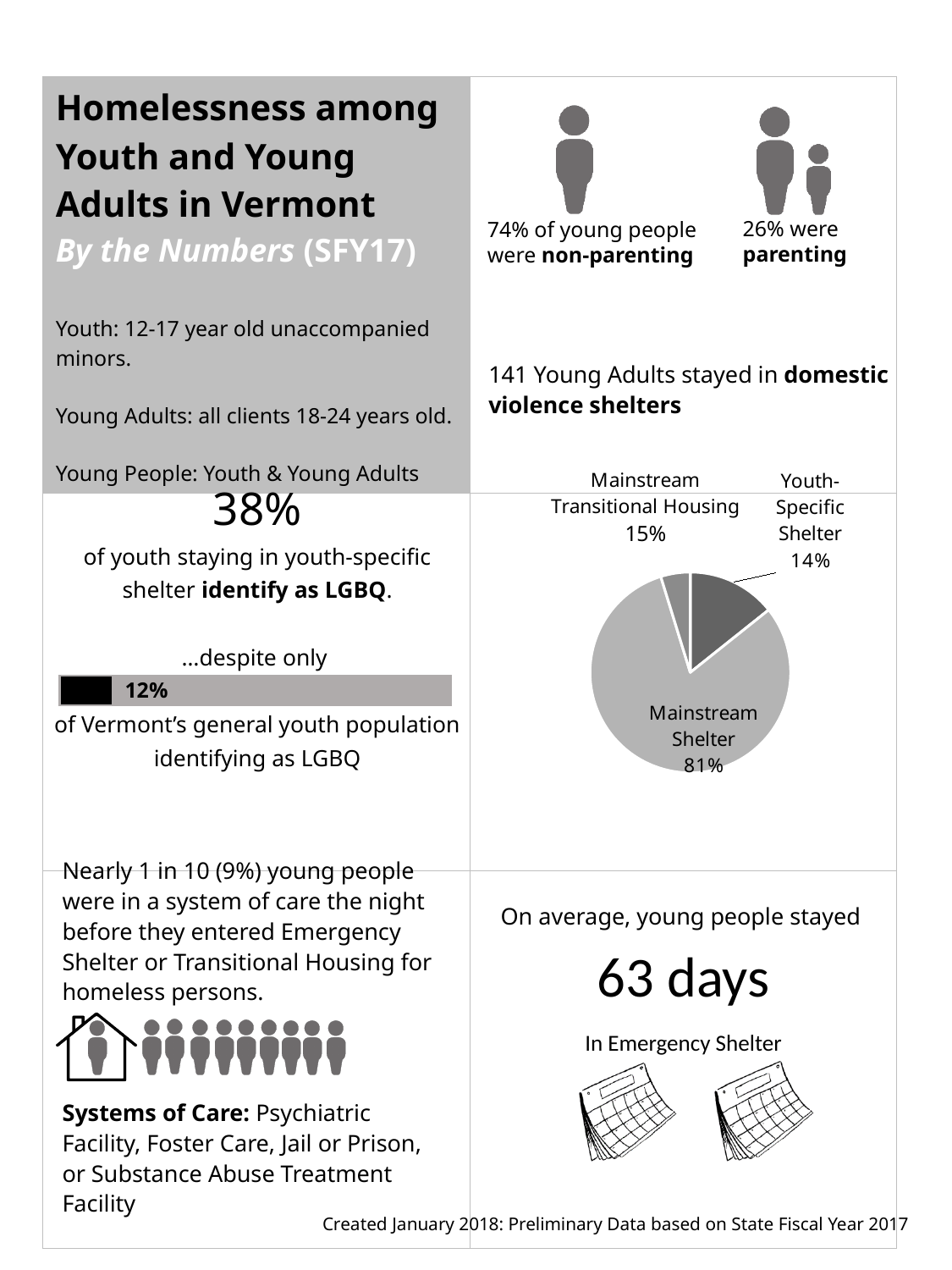
What is the value shown for Youth-Specific Shelter in the pie chart? 14% What percentage is shown on the horizontal bar in the LGBQ section of the slide? 12% Which is larger in the pie chart, Mainstream Shelter or Mainstream Transitional Housing? Mainstream Shelter What kind of chart is shown on the slide? pie chart Which slice of the pie chart is the largest? Mainstream Shelter What share of the pie chart is Mainstream Shelter? 81% What is the difference between the Mainstream Shelter and Youth-Specific Shelter values in the pie chart? 67% How many slices does the pie chart have? 3 What is the difference between the Mainstream Shelter and Mainstream Transitional Housing values in the pie chart? 66% Which slice of the pie chart is shown in the darkest shade? Youth-Specific Shelter What is the value shown for Mainstream Transitional Housing in the pie chart? 15%